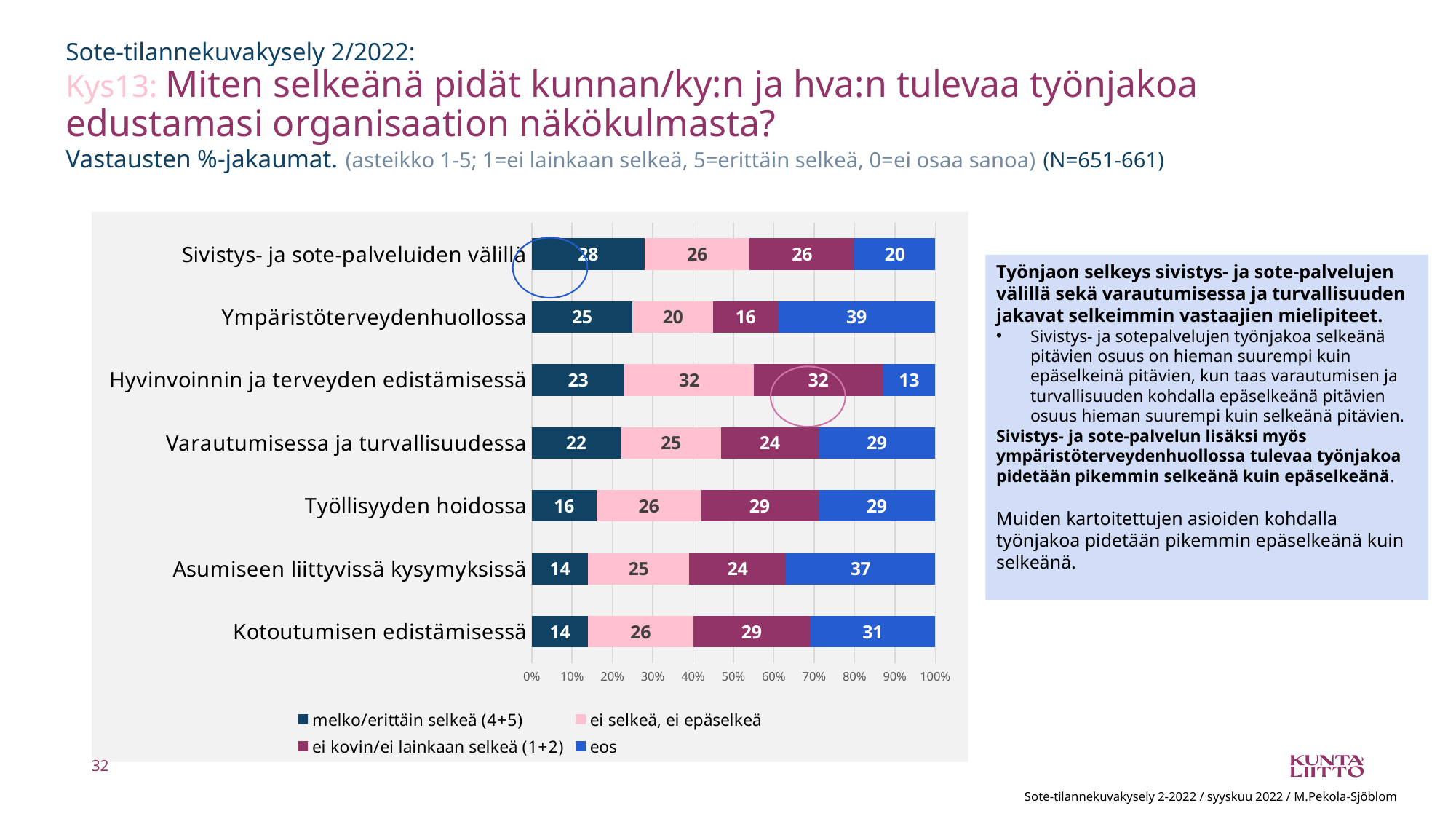
What is the difference between the "eos" value for Ympäristöterveydenhuollossa and the "eos" value for Sivistys- ja sote-palveluiden välillä? 19 What is the value for "ei kovin/ei lainkaan selkeä (1+2)" for Hyvinvoinnin ja terveyden edistämisessä? 32 What is the total of the stacked bar for Sivistys- ja sote-palveluiden välillä? 100 Which category has the lowest "eos" value? Hyvinvoinnin ja terveyden edistämisessä Which legend entry is shown in light pink? ei selkeä, ei epäselkeä What is the "eos" value for Asumiseen liittyvissä kysymyksissä? 37 Which is larger for Varautumisessa ja turvallisuudessa: the "melko/erittäin selkeä (4+5)" value or the "ei kovin/ei lainkaan selkeä (1+2)" value? ei kovin/ei lainkaan selkeä (1+2) What kind of chart is shown on the slide? Stacked bar chart How many series does the legend list? 4 What is the value for "melko/erittäin selkeä (4+5)" for Ympäristöterveydenhuollossa? 25 How many categories are shown on the chart? 7 Which category has the highest value for "melko/erittäin selkeä (4+5)"? Sivistys- ja sote-palveluiden välillä